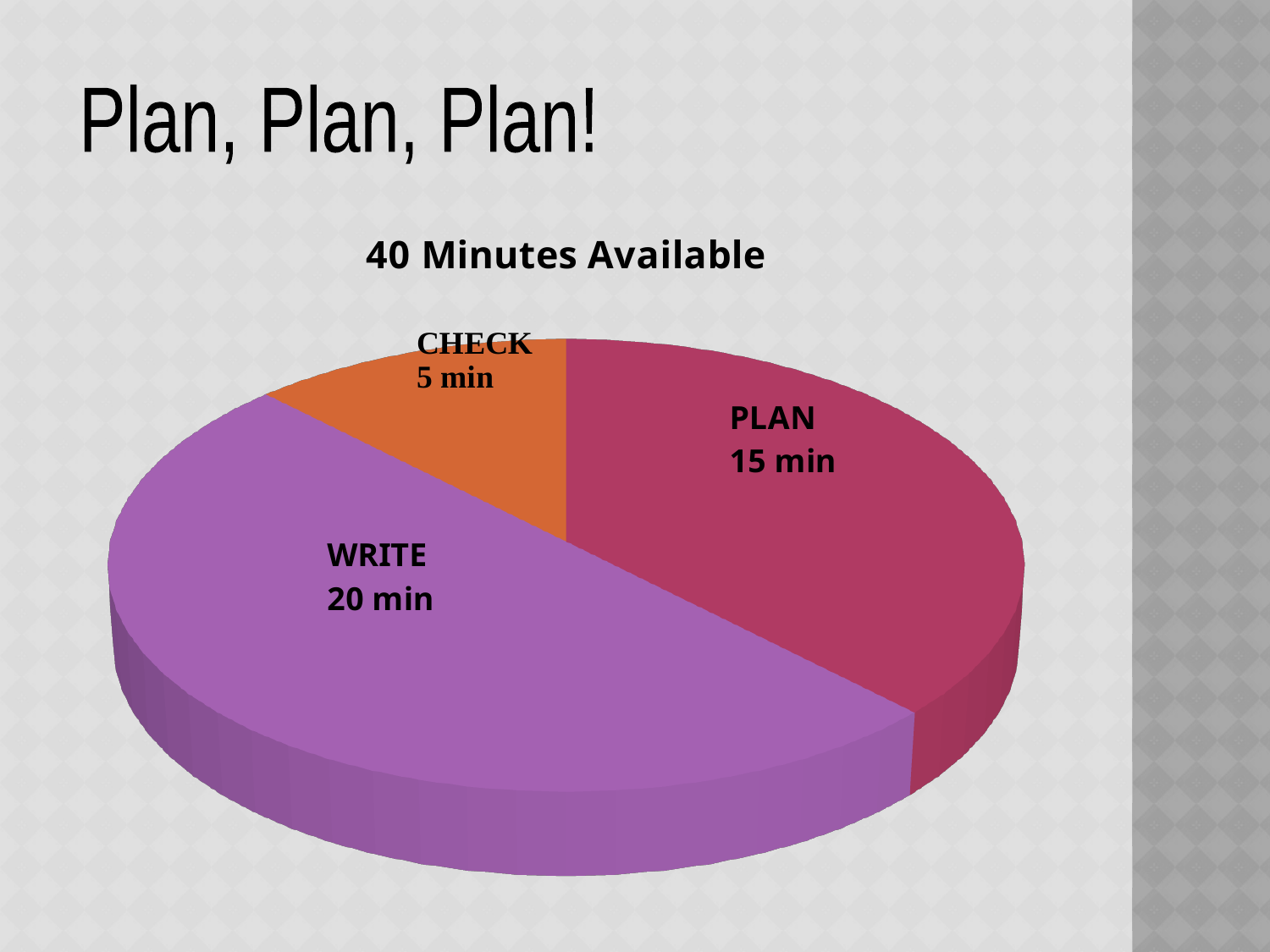
What is the difference in minutes between WRITE and PLAN? 5 min How many minutes are allocated to PLAN? 15 min What share of the total 40 minutes does WRITE take? 50% Which activity has the largest slice of the pie? WRITE How many minutes are allocated to CHECK? 5 min What kind of chart is shown on the slide? pie chart Which activity has the smallest slice of the pie? CHECK Which is larger, the PLAN slice or the CHECK slice? PLAN How many slices does the pie chart have? 3 What colour is the WRITE slice? purple How many minutes are allocated to WRITE? 20 min What is the title of the chart? 40 Minutes Available